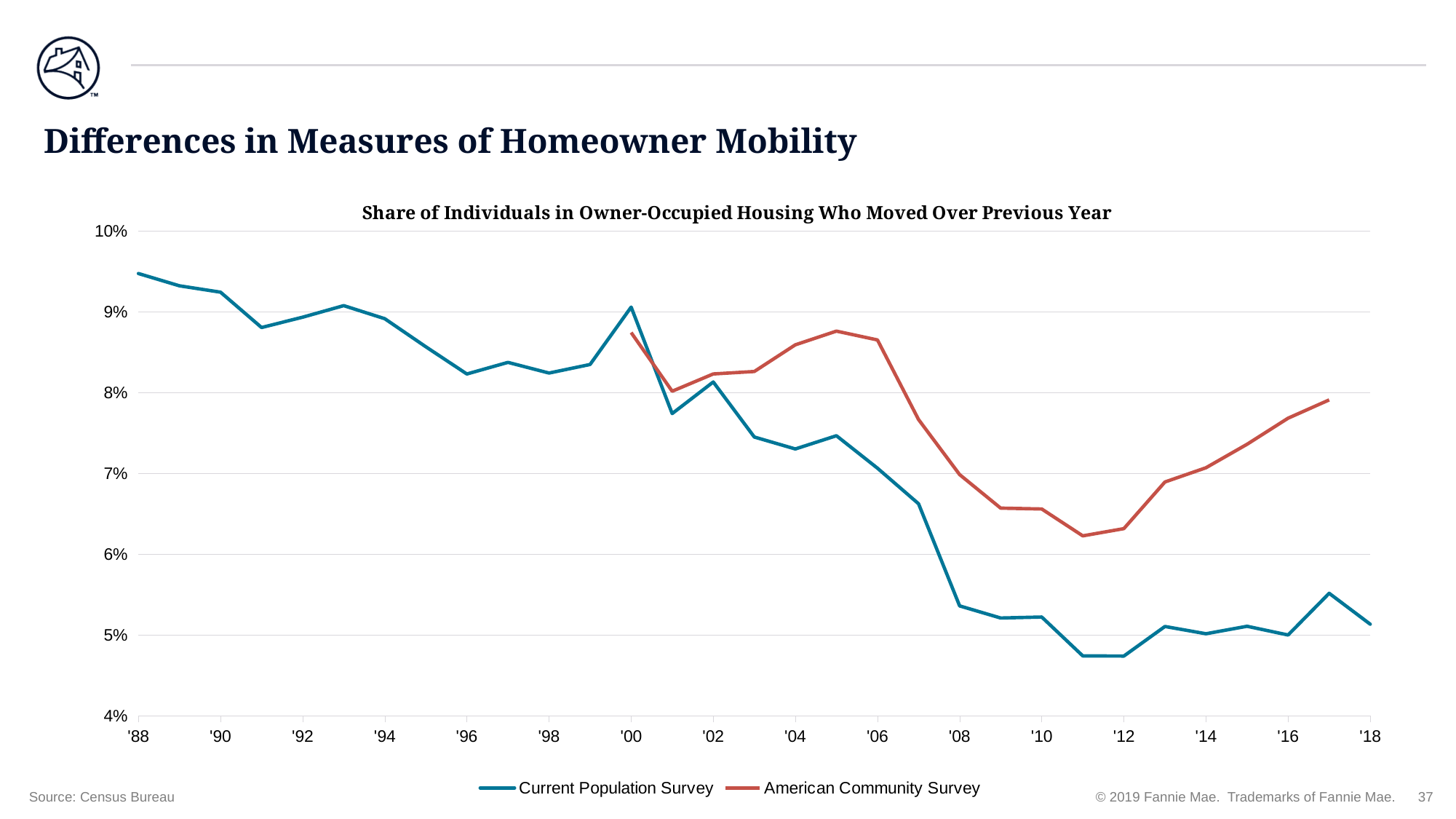
In '00, which series has the higher value, Current Population Survey or American Community Survey? Current Population Survey What is the title of the chart? Share of Individuals in Owner-Occupied Housing Who Moved Over Previous Year In which year does the Current Population Survey series reach its highest value? '88 Is the American Community Survey value for '05 greater or less than 8%? greater What kind of chart is shown on the slide? line chart Is the Current Population Survey value for '88 greater or less than 9%? greater What are the two series named in the legend? Current Population Survey and American Community Survey In '10, which series has the higher value, Current Population Survey or American Community Survey? American Community Survey How many series does the legend list? 2 Is the American Community Survey value for '11 greater or less than 7%? less